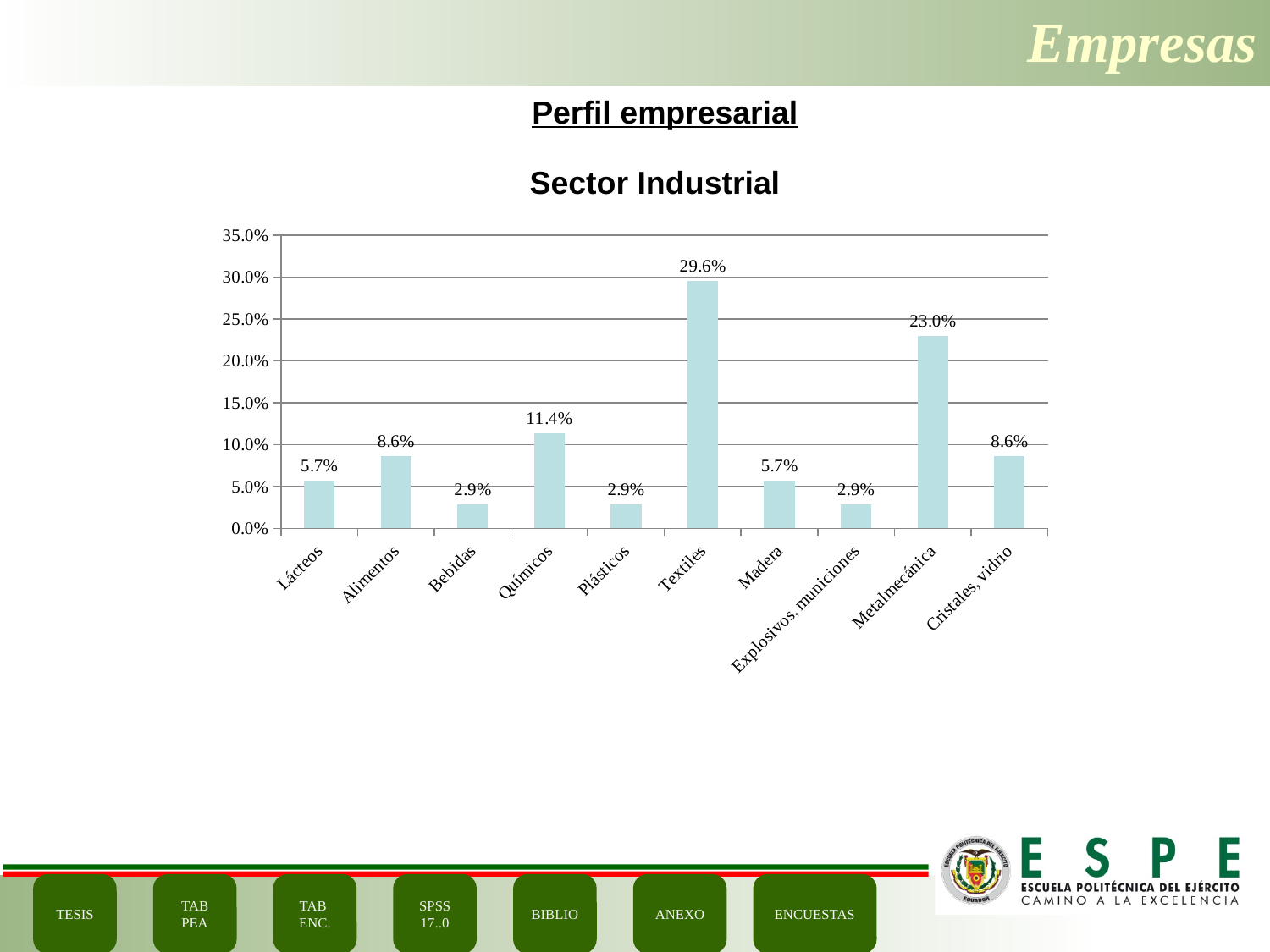
What is the value for Lácteos? 5.7% What is the difference between the values for Textiles and Metalmecánica? 6.6% What is the title of the chart? Sector Industrial Which sector has the highest value? Textiles What is the value for Químicos? 11.4% What is the difference between the values for Químicos and Bebidas? 8.5% Is the value for Metalmecánica greater or less than 20.0%? greater Which is larger, the value for Alimentos or the value for Madera? Alimentos How many sectors are shown on the x axis? 10 What is the value for Metalmecánica? 23.0% What is the value for Textiles? 29.6% What kind of chart is shown? bar chart